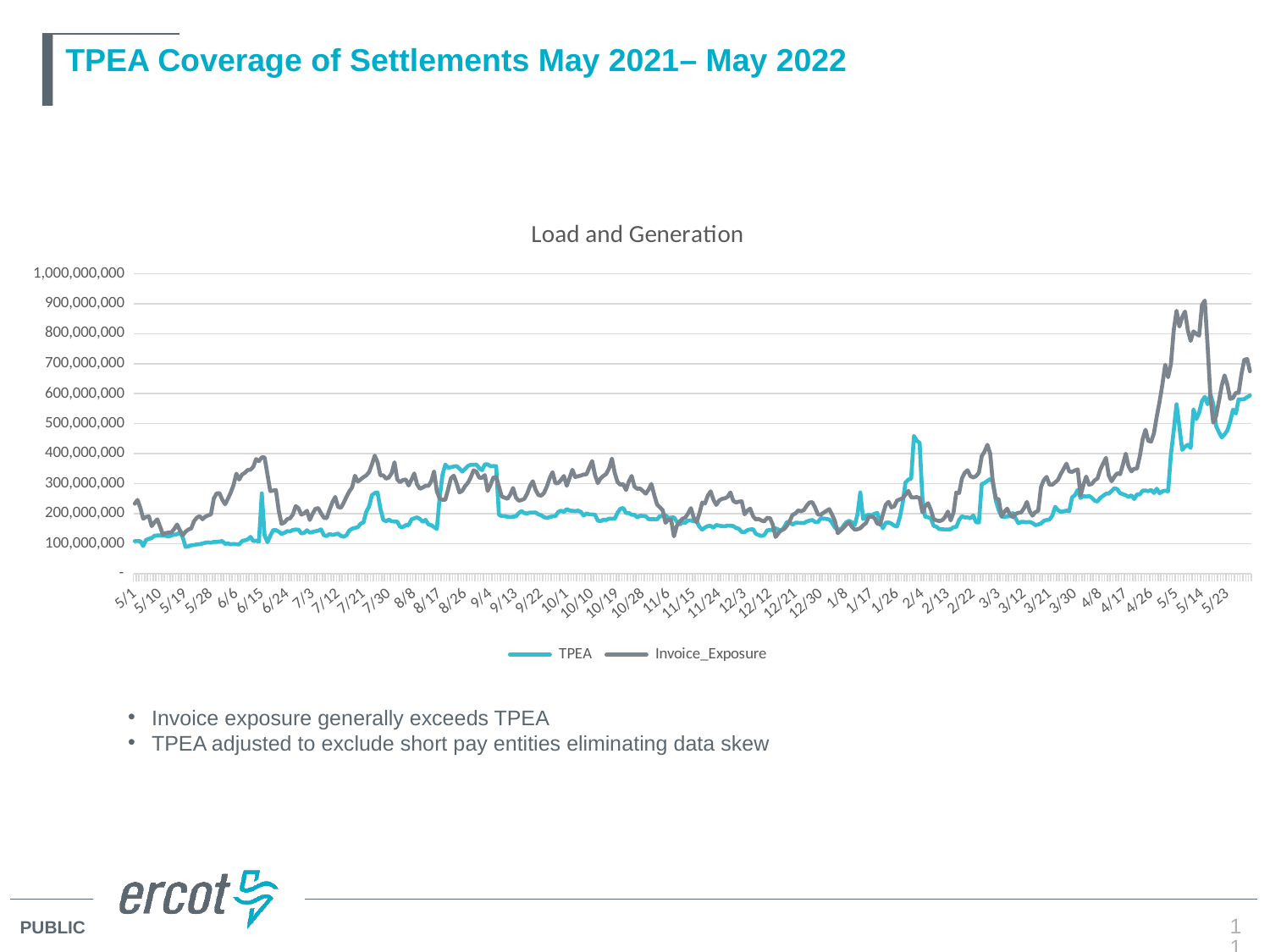
Is the TPEA spike around 2/4 greater or less than 400,000,000? greater Around 2/4, which series is higher, TPEA or Invoice_Exposure? TPEA What kind of chart is shown on the slide? line chart Is the Invoice_Exposure value around 6/15 greater or less than 300,000,000? greater Is the peak value of Invoice_Exposure around 5/14 greater or less than 800,000,000? greater What is the title of the chart? Load and Generation Does the TPEA line generally rise or fall between 3/30 and 5/23? rise How many series does the chart legend list? 2 Which series reaches the highest value anywhere on the chart, TPEA or Invoice_Exposure? Invoice_Exposure Around 5/14 (2022), which series is higher, TPEA or Invoice_Exposure? Invoice_Exposure Which two series are listed in the chart legend? TPEA and Invoice_Exposure